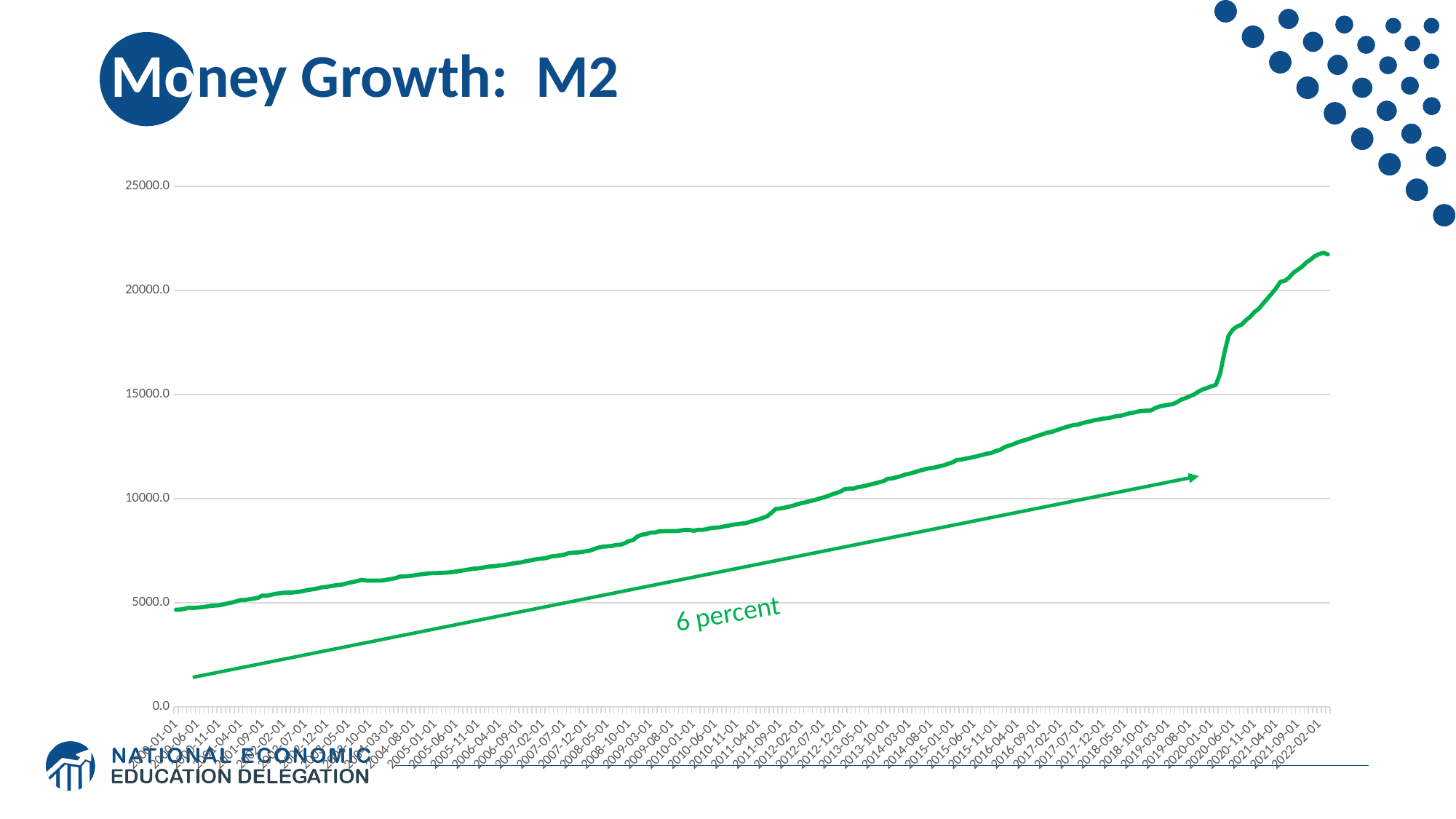
Do the M2 values generally rise or fall from left to right along the x axis? rise Which is larger, the M2 value at 2012-02-01 or the M2 value at 2021-04-01? 2021-04-01 Is the M2 value at 2020-06-01 greater or less than 15000.0? greater What text labels the straight arrow drawn beneath the M2 line? 6 percent What kind of chart is shown on the slide? line chart Is the M2 value at 2010-01-01 greater or less than 10000.0? less Is the M2 value at 2005-01-01 greater or less than 10000.0? less What is the highest value shown on the chart's y axis? 25000.0 What is the title of the slide's chart? Money Growth: M2